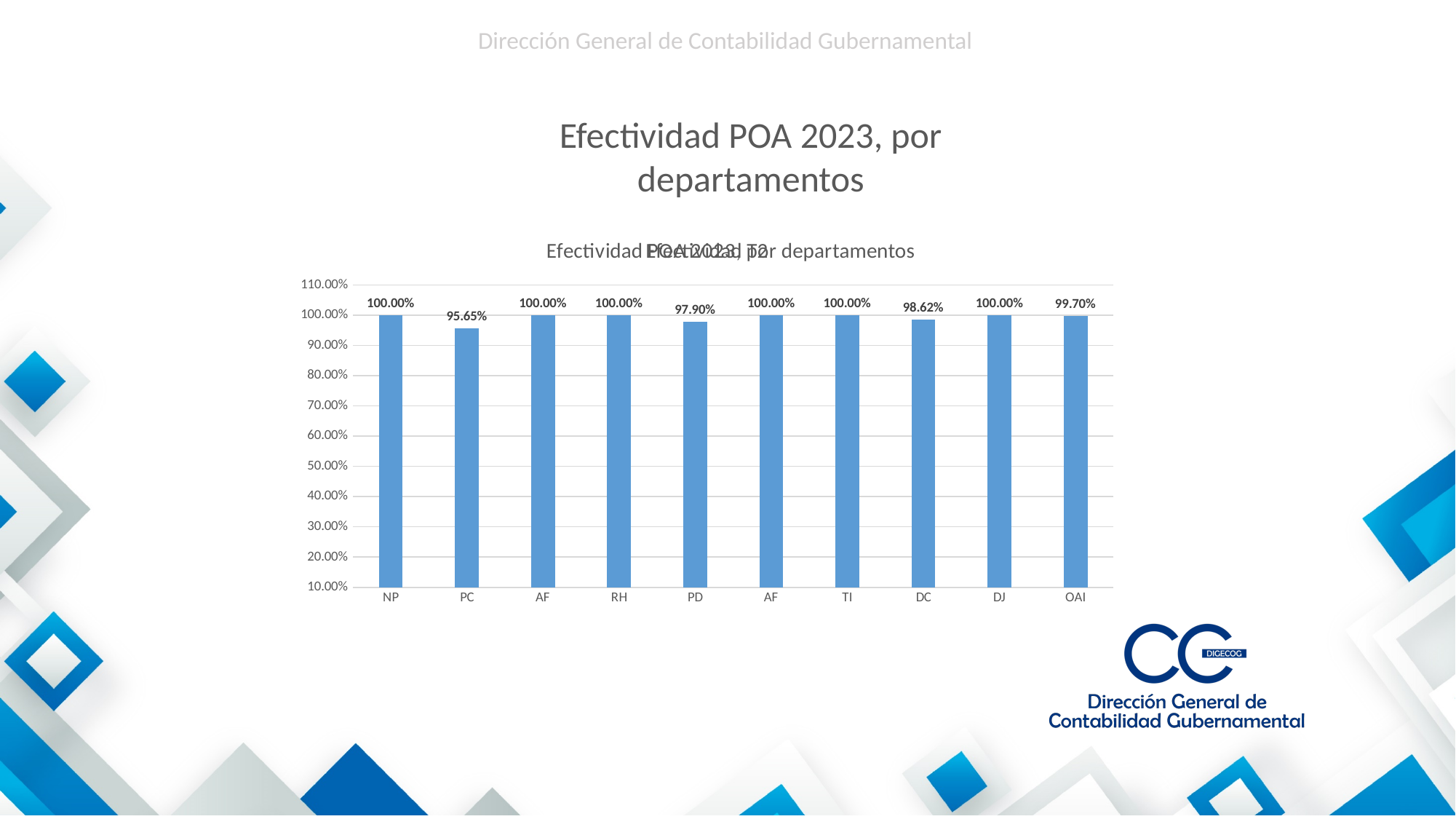
How many departments are shown on the x axis? 10 Which department has the lowest value? PC What kind of chart is shown on the slide? Bar chart What is the value for PC? 95.65% What is the value for NP? 100.00% What is the difference between the values for NP and PC? 4.35% What is the value for OAI? 99.70% What is the value for DC? 98.62% What is the difference between the values for DC and PD? 0.72% What is the value for PD? 97.90% How many bars reach 100.00%? 6 Which is larger, the value for PD or the value for DC? DC